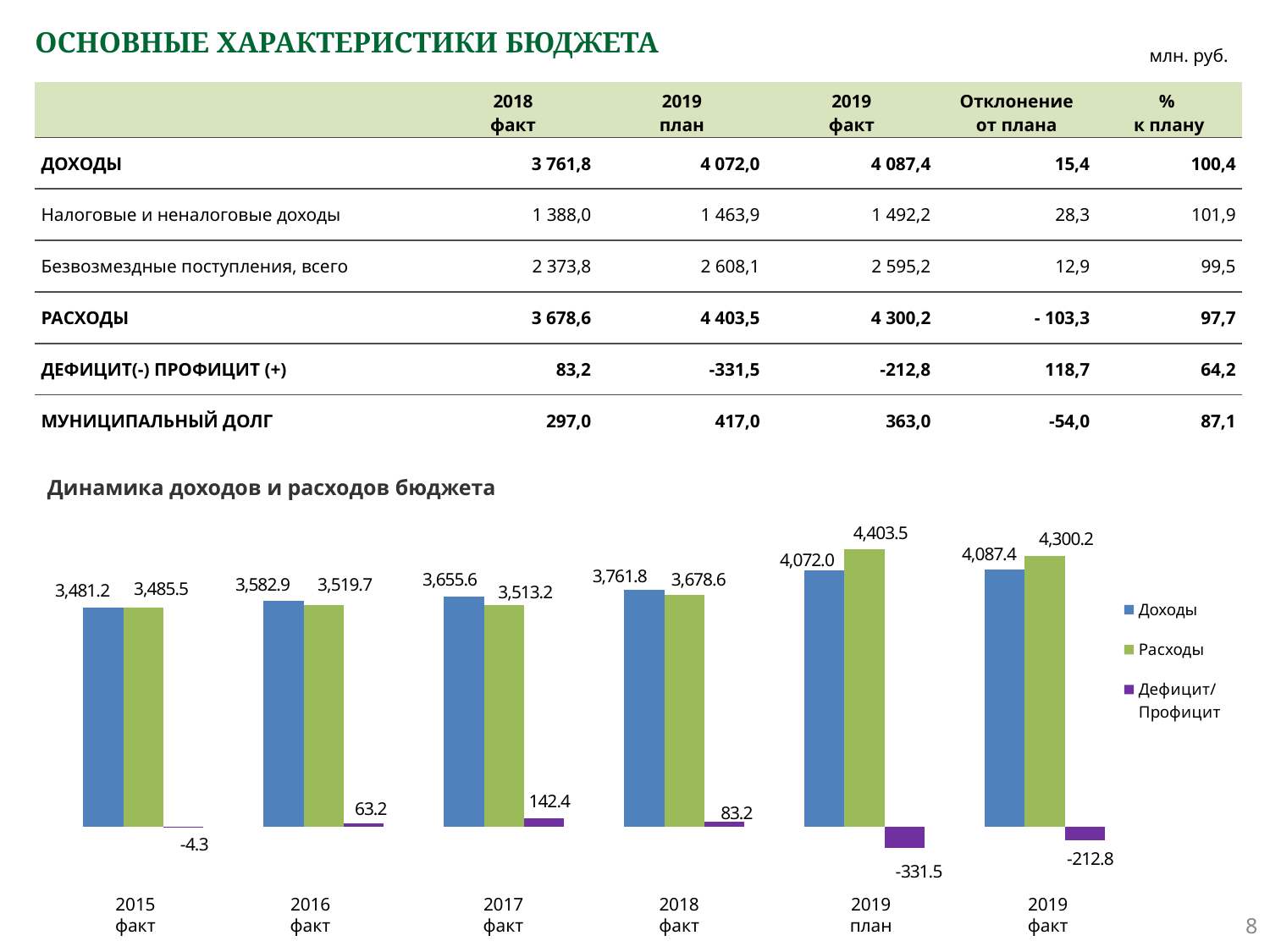
How many series does the legend of the chart list? 3 How many categories are shown along the x axis of the chart? 6 What is the difference between Доходы and Расходы for 2018 факт in the chart? 83.2 In which category is Расходы highest in the chart? 2019 план What colour are the Дефицит/Профицит bars in the chart? Purple For 2019 факт, which is larger in the chart: Доходы or Расходы? Расходы What type of chart is shown under the heading 'Динамика доходов и расходов бюджета'? Bar chart Do the Доходы values rise or fall from 2015 факт to 2019 факт in the chart? Rise What is the value of Дефицит/Профицит for 2016 факт in the chart? 63.2 What is the value of Доходы for 2017 факт in the chart? 3,655.6 In which category is Дефицит/Профицит lowest in the chart? 2019 план What is the value of Расходы for 2019 план in the chart? 4,403.5